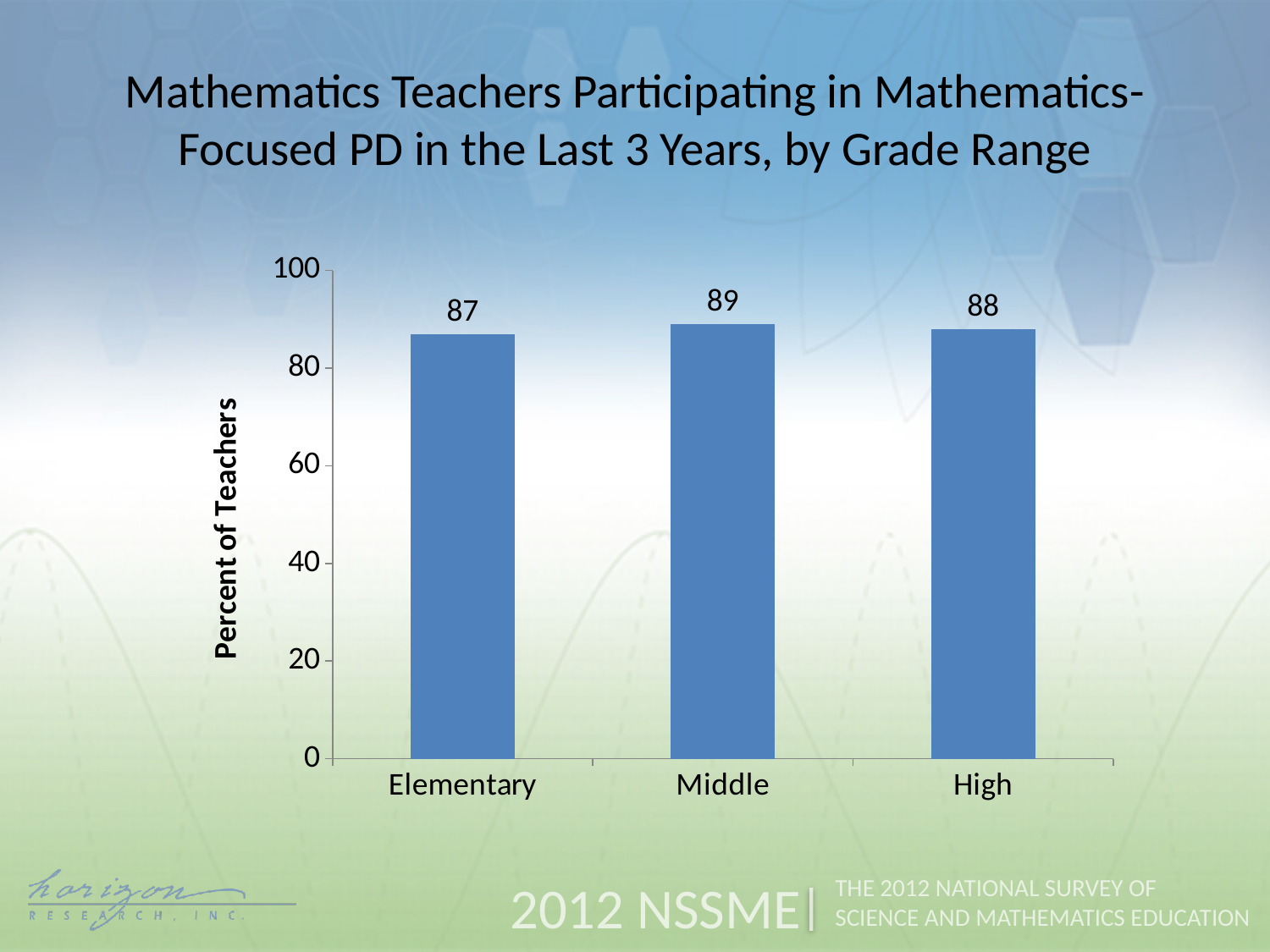
What is the value for Elementary? 87 What is the difference between the values for High and Elementary? 1 Is the value for Elementary greater or less than 80? greater Which grade range has the lowest percent of teachers? Elementary What is the label of the vertical axis? Percent of Teachers Which grade range has the highest percent of teachers? Middle What is the value for Middle? 89 How many grade ranges are shown on the chart? 3 What kind of chart is shown on the slide? bar chart What is the value for High? 88 Which is larger, the value for Middle or the value for High? Middle What is the difference between the values for Middle and Elementary? 2